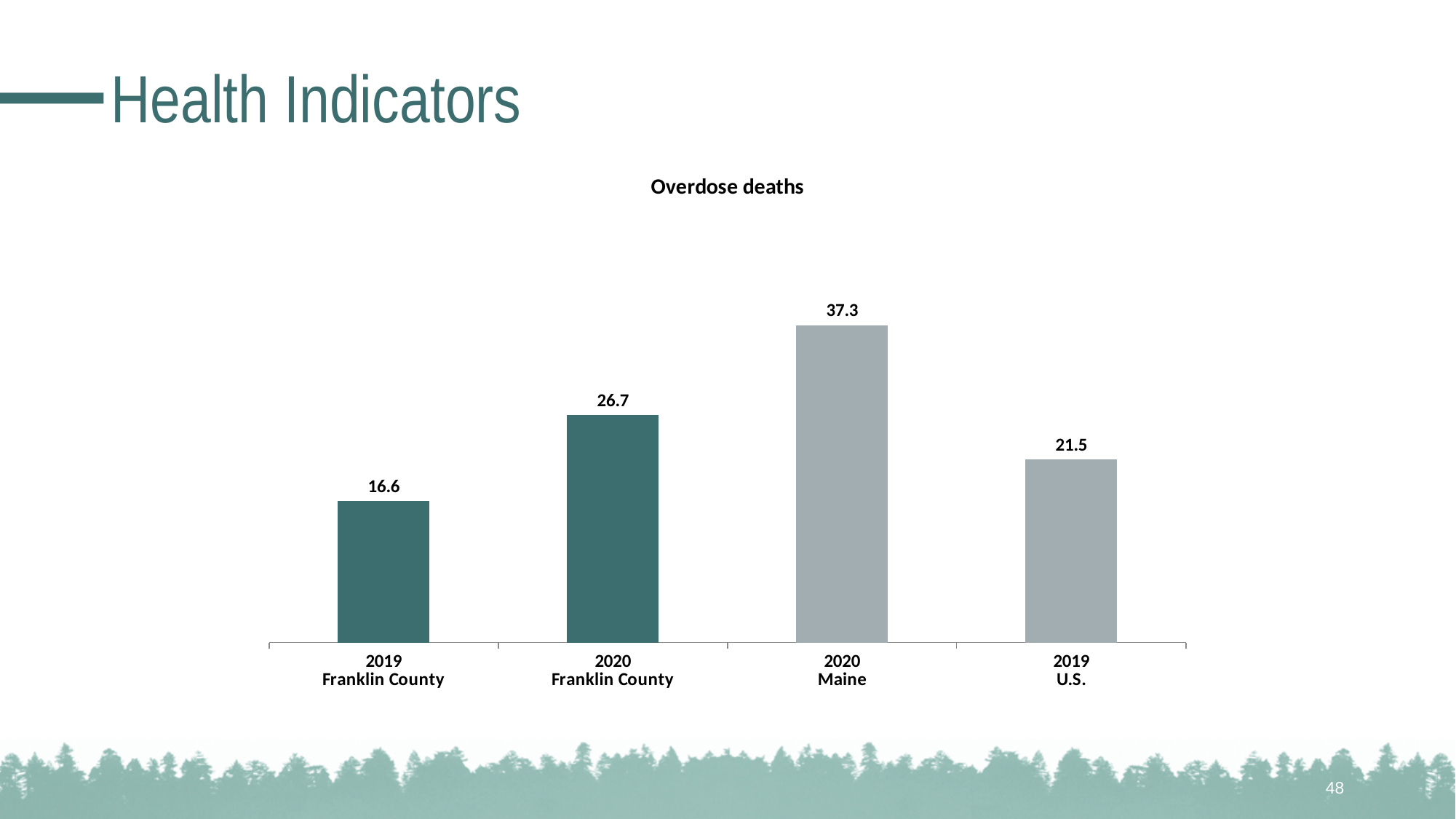
Which category has the highest value in the Overdose deaths chart? 2020 Maine Which category has the lowest value in the Overdose deaths chart? 2019 Franklin County What is the value for 2020 Maine in the Overdose deaths chart? 37.3 What kind of chart is shown on the slide? Bar chart What is the title of the chart on the slide? Overdose deaths What is the difference between the 2020 Franklin County and 2019 Franklin County values in the Overdose deaths chart? 10.1 What is the difference between the 2020 Maine and 2019 U.S. values in the Overdose deaths chart? 15.8 Did the Franklin County value rise or fall from 2019 to 2020 in the Overdose deaths chart? Rise What is the value for 2020 Franklin County in the Overdose deaths chart? 26.7 What is the value for 2019 U.S. in the Overdose deaths chart? 21.5 How many bars are shown in the Overdose deaths chart? 4 Which is larger in the Overdose deaths chart: 2020 Franklin County or 2019 U.S.? 2020 Franklin County